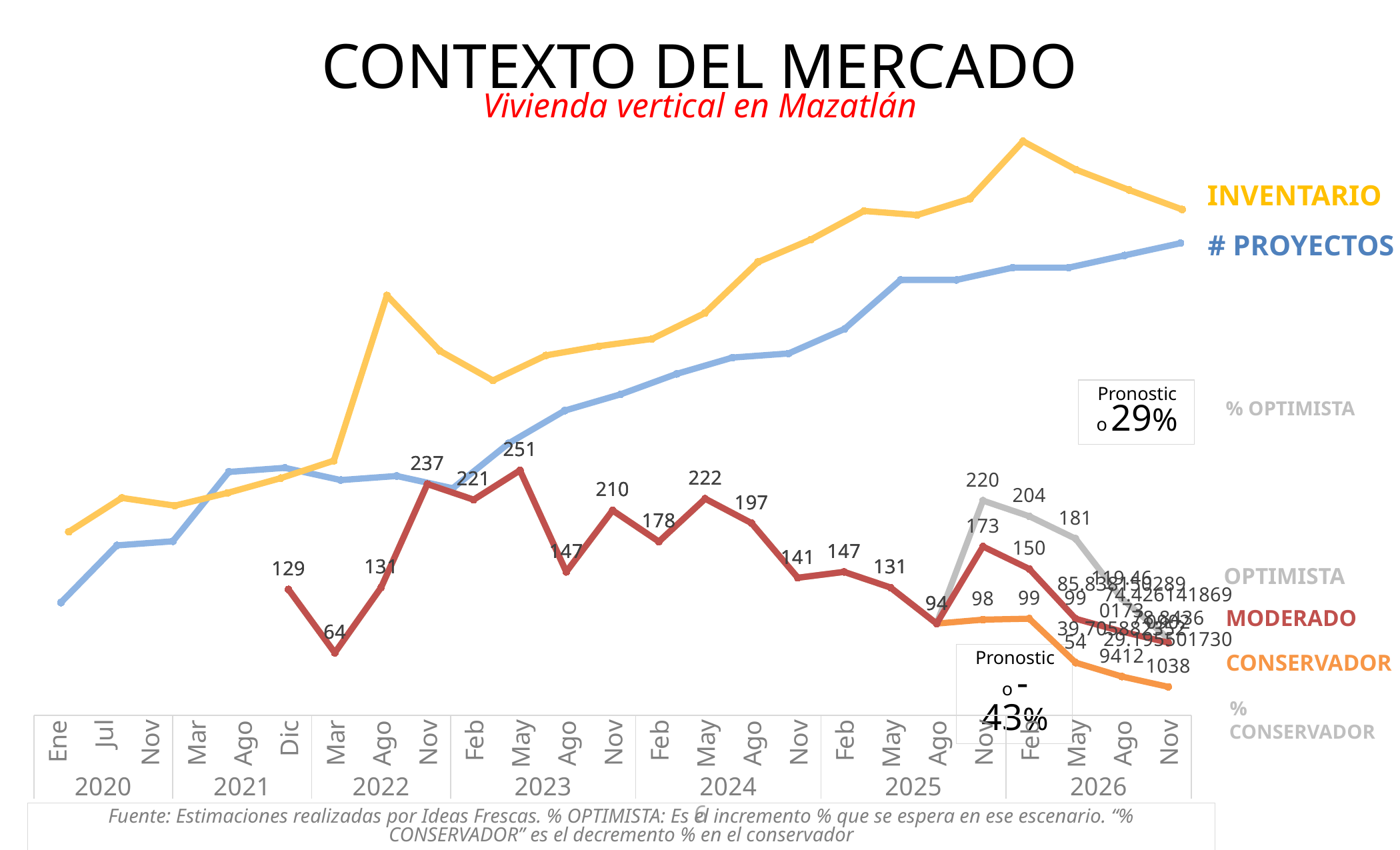
What kind of chart is shown on the slide? line chart What percentage is shown in the 'Pronostico' box for the optimistic scenario? 29% What is the value of the MODERADO series in Ago 2025? 94 Which is larger for the MODERADO series: Nov 2023 or Feb 2024? Nov 2023 Among the labeled MODERADO values, which month has the highest value? May 2023 In Nov 2025, how much higher is the OPTIMISTA value than the MODERADO value? 47 Among the labeled MODERADO values, which month has the lowest value? Mar 2022 What is the value of the OPTIMISTA series in Nov 2025? 220 What is the difference between the MODERADO values in Nov 2022 and Feb 2023? 16 What is the value of the MODERADO series in May 2023? 251 What is the value of the MODERADO series in Mar 2022? 64 What is the value of the CONSERVADOR series in May 2026? 54